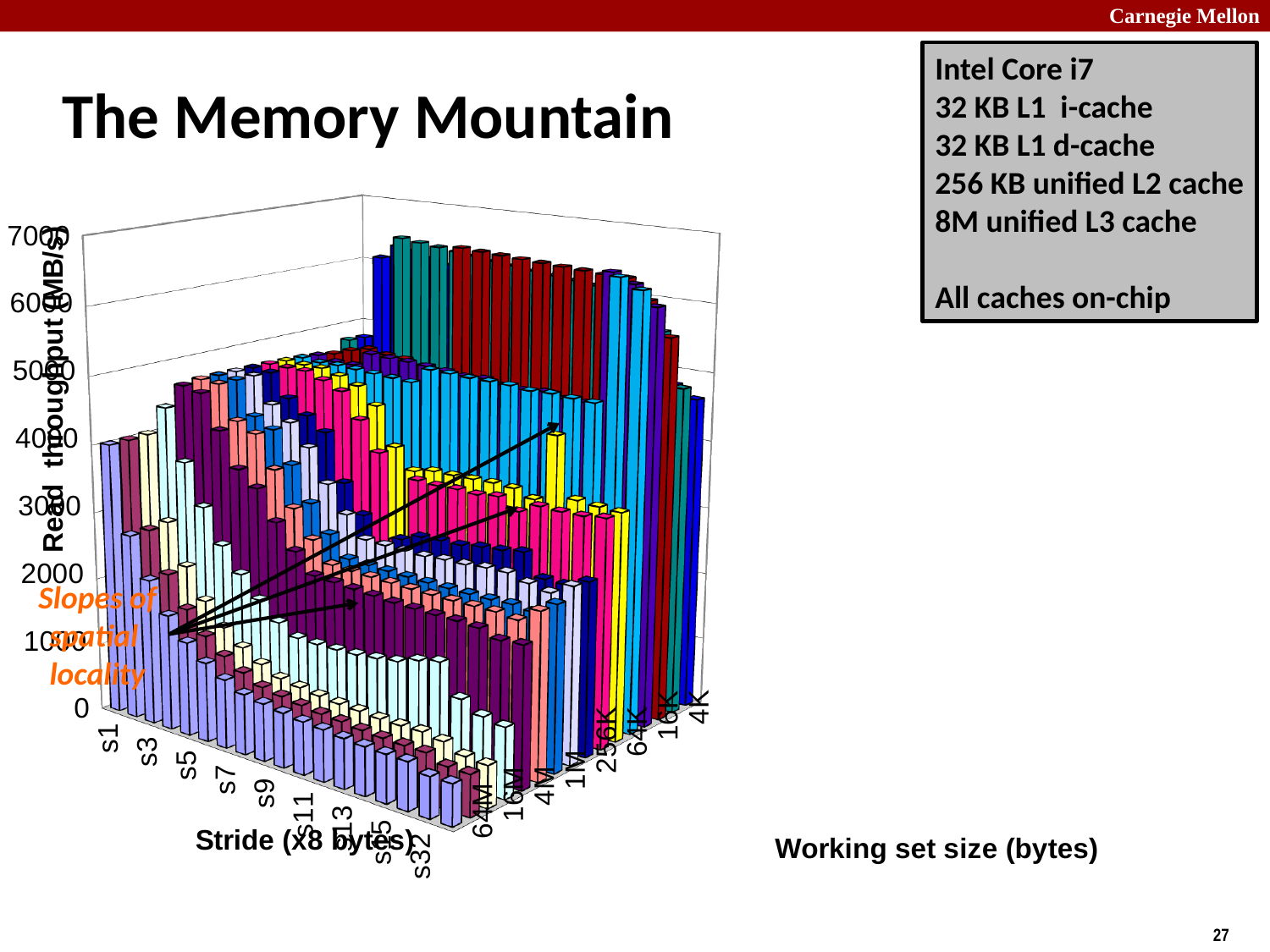
What is the title of the chart on the slide? The Memory Mountain Is the read throughput for the tallest bars in the 4K working set row greater or less than 5000? greater What is the label of the stride axis of the chart? Stride (x8 bytes) What is the highest tick value shown on the read throughput axis? 7000 How many stride labels are shown along the stride axis? 9 How many working set size labels are shown along the depth axis? 8 For the 64M working set row, does read throughput rise or fall as the stride increases from s1 to s32? fall What kind of chart is shown on the slide? 3D bar chart